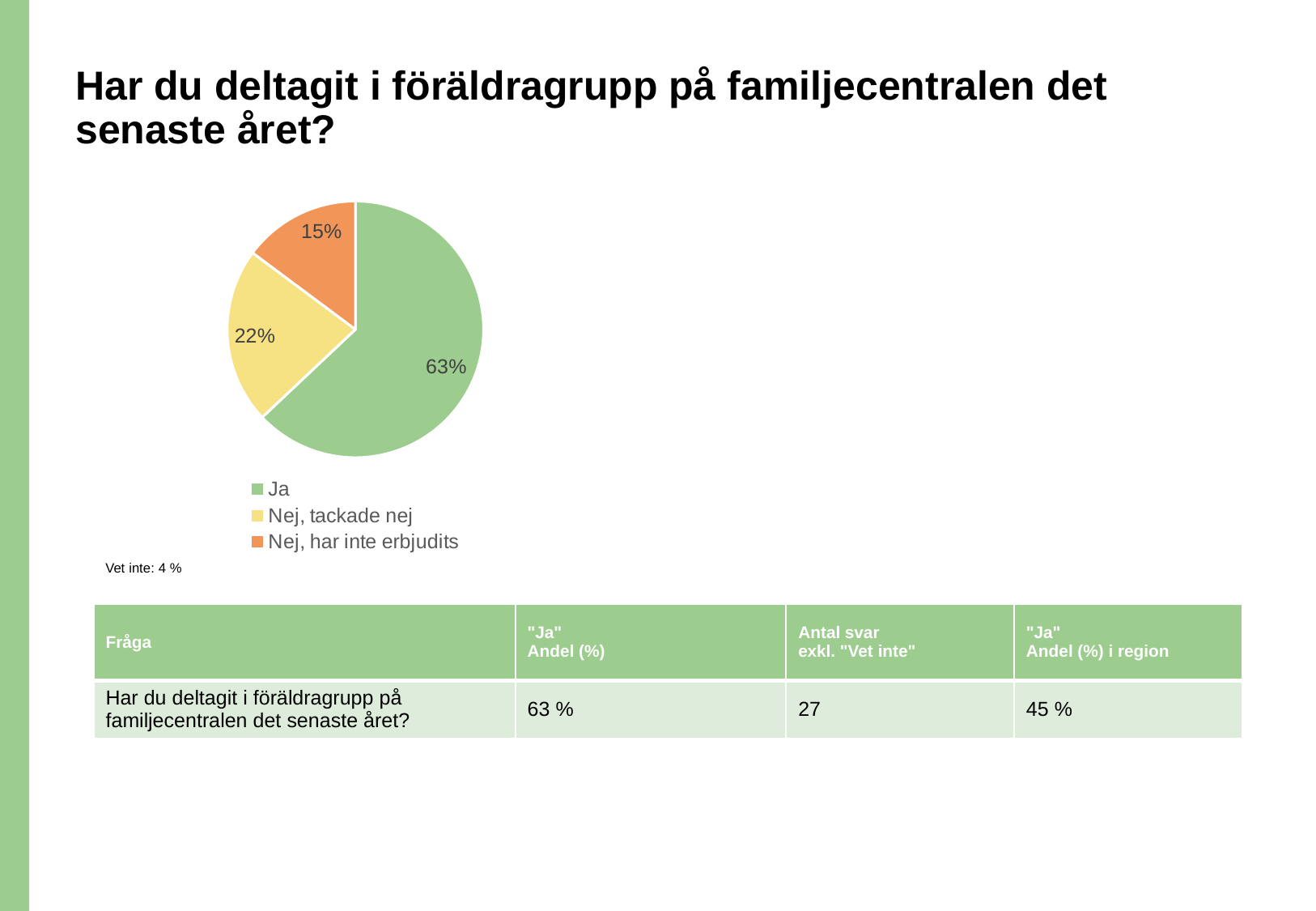
What share of the pie does "Nej, tackade nej" have? 22% Which is larger, the slice for "Nej, tackade nej" or the slice for "Nej, har inte erbjudits"? Nej, tackade nej What colour is the slice for "Ja"? green What share of the pie does "Ja" have? 63% Which category has the smallest slice of the pie? Nej, har inte erbjudits Which category has the largest slice of the pie? Ja What is the difference in percentage points between "Nej, tackade nej" and "Nej, har inte erbjudits"? 7 What kind of chart is shown on the slide? pie chart How many slices does the pie chart have? 3 What is the difference in percentage points between "Ja" and "Nej, tackade nej"? 41 What share of the pie does "Nej, har inte erbjudits" have? 15% How many entries does the legend list? 3